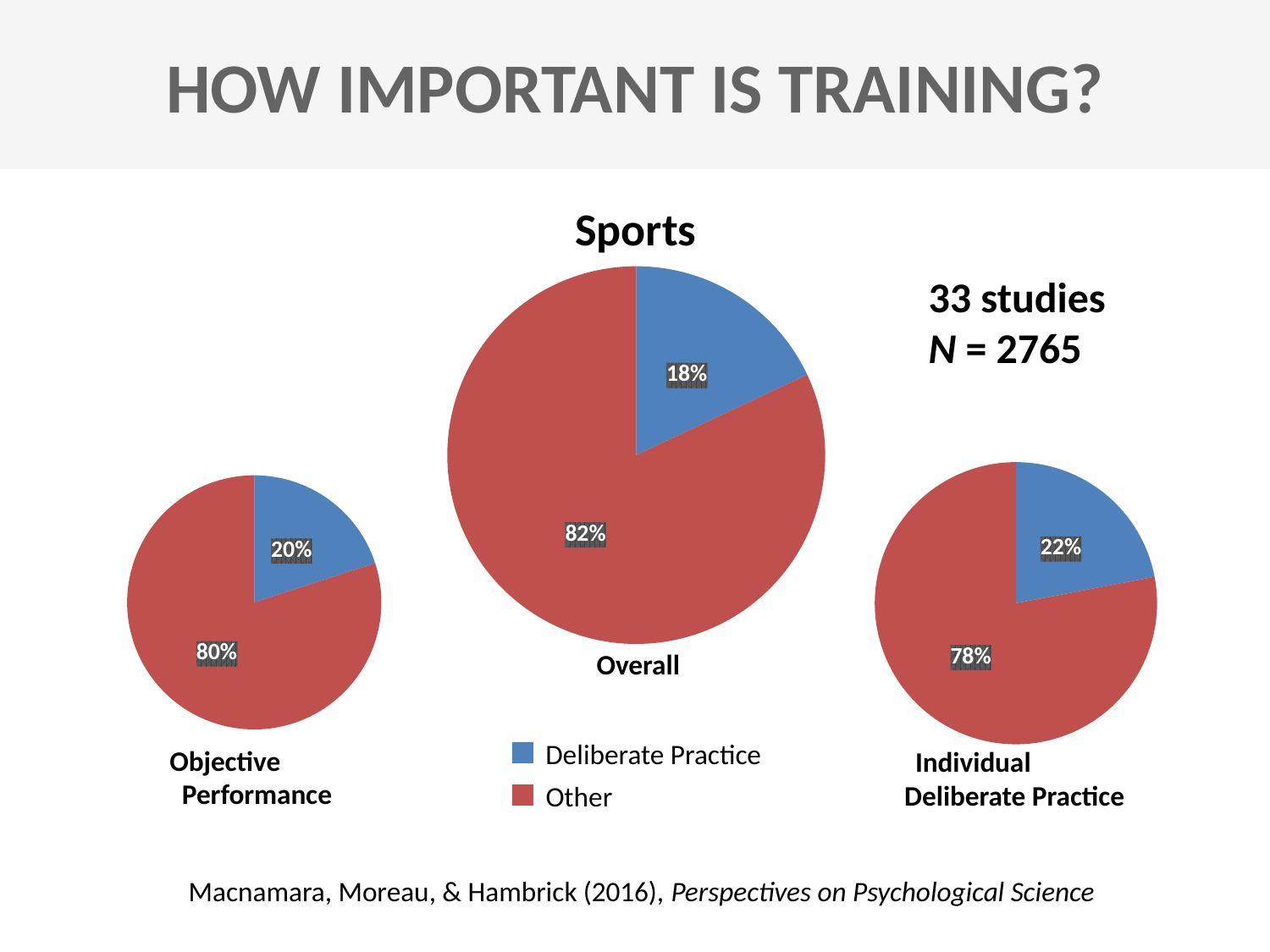
In the Overall pie chart, what share is labelled for Other? 82% In the Overall pie chart, which slice is larger, Deliberate Practice or Other? Other What kind of chart is the Overall chart? Pie chart In the Individual Deliberate Practice pie chart, what share is labelled for Deliberate Practice? 22% How many slices does the Objective Performance pie chart have? 2 In the Individual Deliberate Practice pie chart, what share is labelled for Other? 78% How many entries does the legend list? 2 What is the difference between the Other share and the Deliberate Practice share in the Individual Deliberate Practice pie chart? 56% Which colour represents Deliberate Practice in the legend? Blue